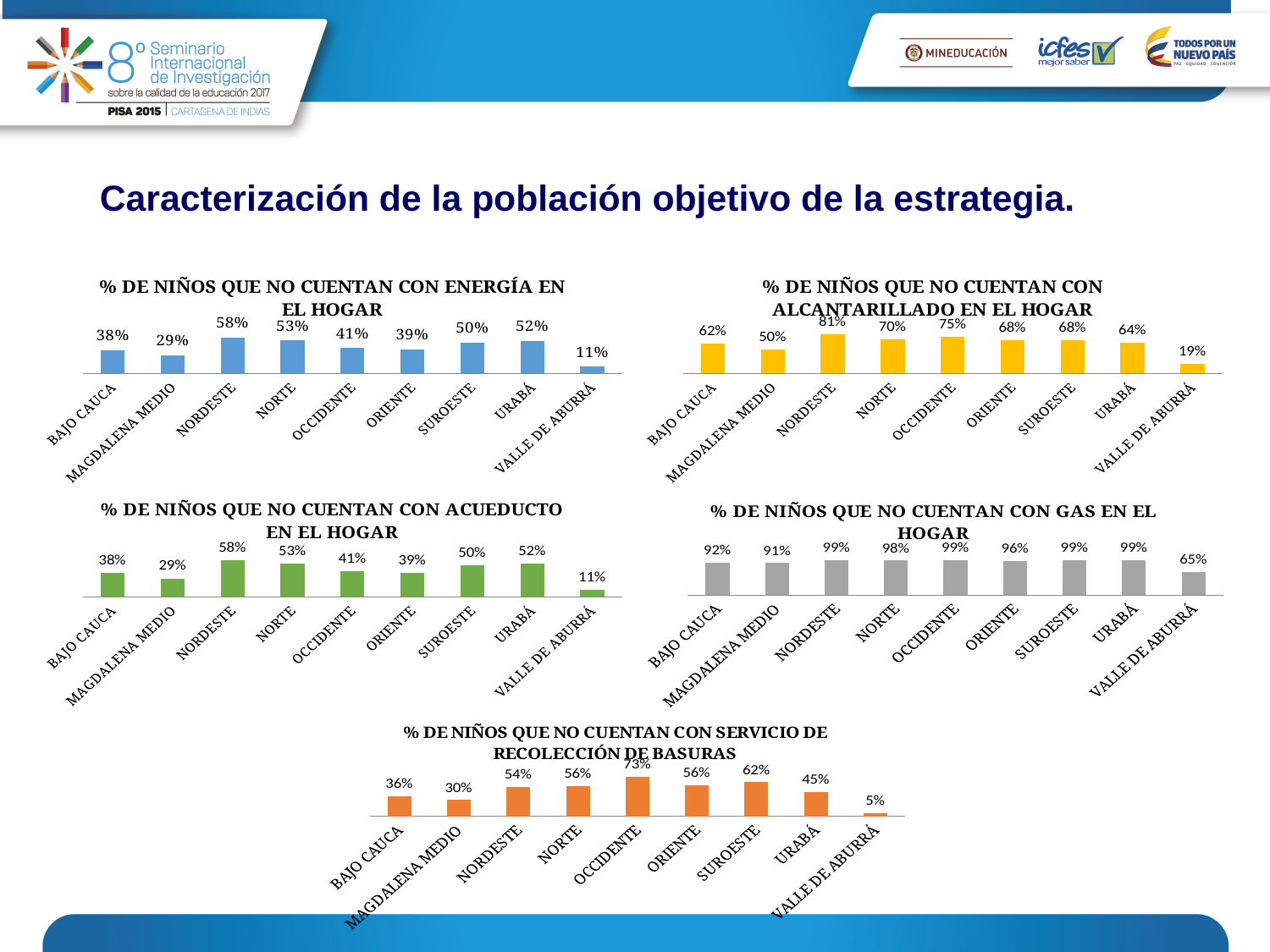
In the chart '% DE NIÑOS QUE NO CUENTAN CON ALCANTARILLADO EN EL HOGAR', what is the difference between the values for NORDESTE and MAGDALENA MEDIO? 31% What kind of chart is '% DE NIÑOS QUE NO CUENTAN CON ALCANTARILLADO EN EL HOGAR'? Bar chart In the chart '% DE NIÑOS QUE NO CUENTAN CON SERVICIO DE RECOLECCIÓN DE BASURAS', which region has the highest value? OCCIDENTE How many regions are shown in the chart '% DE NIÑOS QUE NO CUENTAN CON GAS EN EL HOGAR'? 9 In the chart '% DE NIÑOS QUE NO CUENTAN CON ENERGÍA EN EL HOGAR', which is larger, the value for NORTE or the value for OCCIDENTE? NORTE How many bar charts are shown on the slide? 5 In the chart '% DE NIÑOS QUE NO CUENTAN CON SERVICIO DE RECOLECCIÓN DE BASURAS', what is the difference between the values for SUROESTE and URABÁ? 17% In the chart '% DE NIÑOS QUE NO CUENTAN CON ALCANTARILLADO EN EL HOGAR', which region has the highest value? NORDESTE In the chart '% DE NIÑOS QUE NO CUENTAN CON ACUEDUCTO EN EL HOGAR', which region has the lowest value? VALLE DE ABURRÁ In the chart '% DE NIÑOS QUE NO CUENTAN CON ALCANTARILLADO EN EL HOGAR', what is the value for VALLE DE ABURRÁ? 19% In the chart '% DE NIÑOS QUE NO CUENTAN CON GAS EN EL HOGAR', what is the value for VALLE DE ABURRÁ? 65% In the chart '% DE NIÑOS QUE NO CUENTAN CON ENERGÍA EN EL HOGAR', what is the value for NORDESTE? 58%